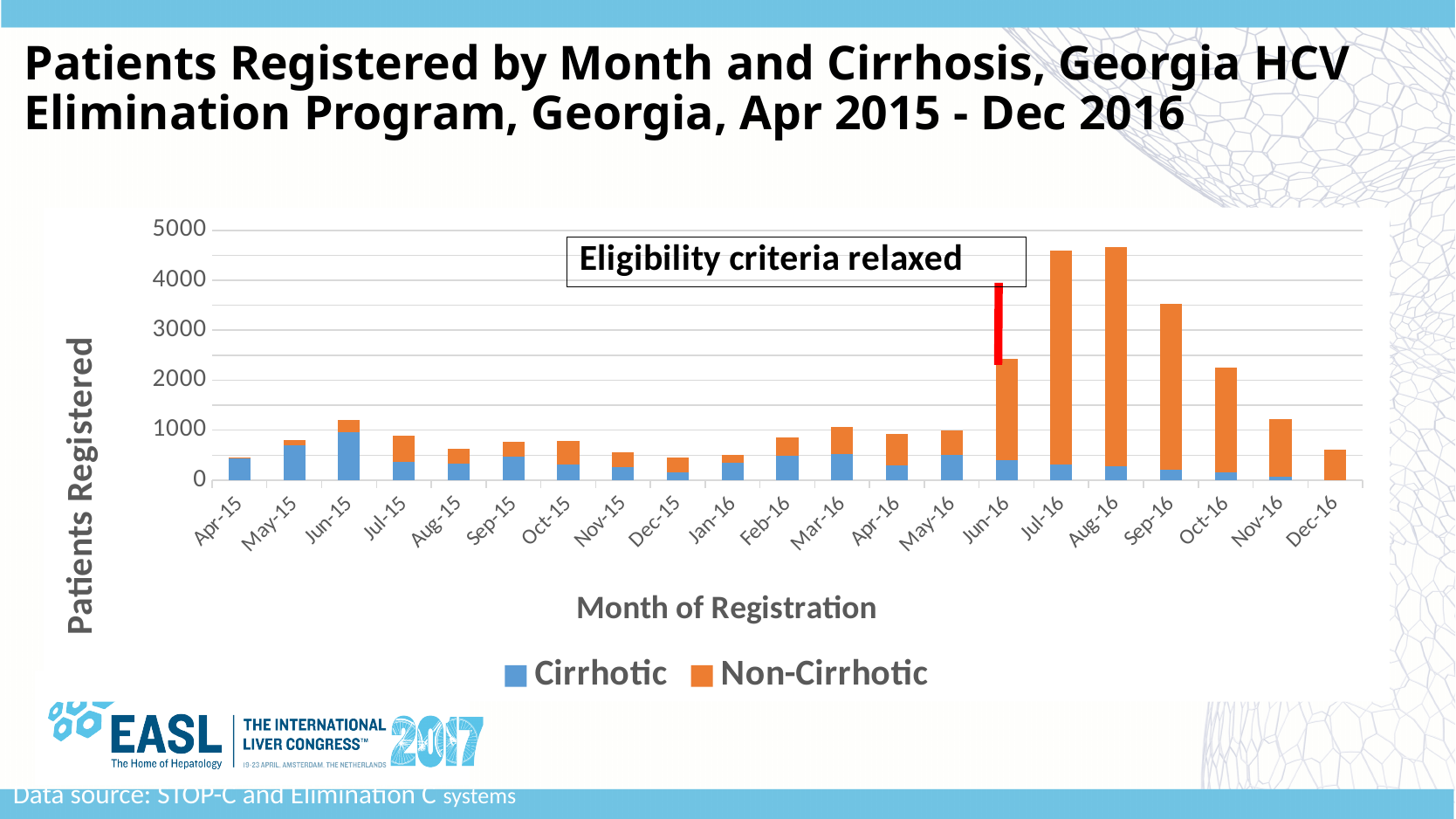
What annotation text is shown in the box above the bars? Eligibility criteria relaxed What is the title of the x axis? Month of Registration How many months are shown on the x axis? 21 Is the total value for Jul-16 greater or less than 4000? greater Which month has the larger total, Jul-16 or Sep-16? Jul-16 Is the total value for Dec-16 greater or less than 1000? less Is the total value for Jun-16 greater or less than 2000? greater What kind of chart is shown on the slide? Stacked bar chart How many series does the legend list? 2 Which month has the larger total, Aug-16 or Oct-16? Aug-16